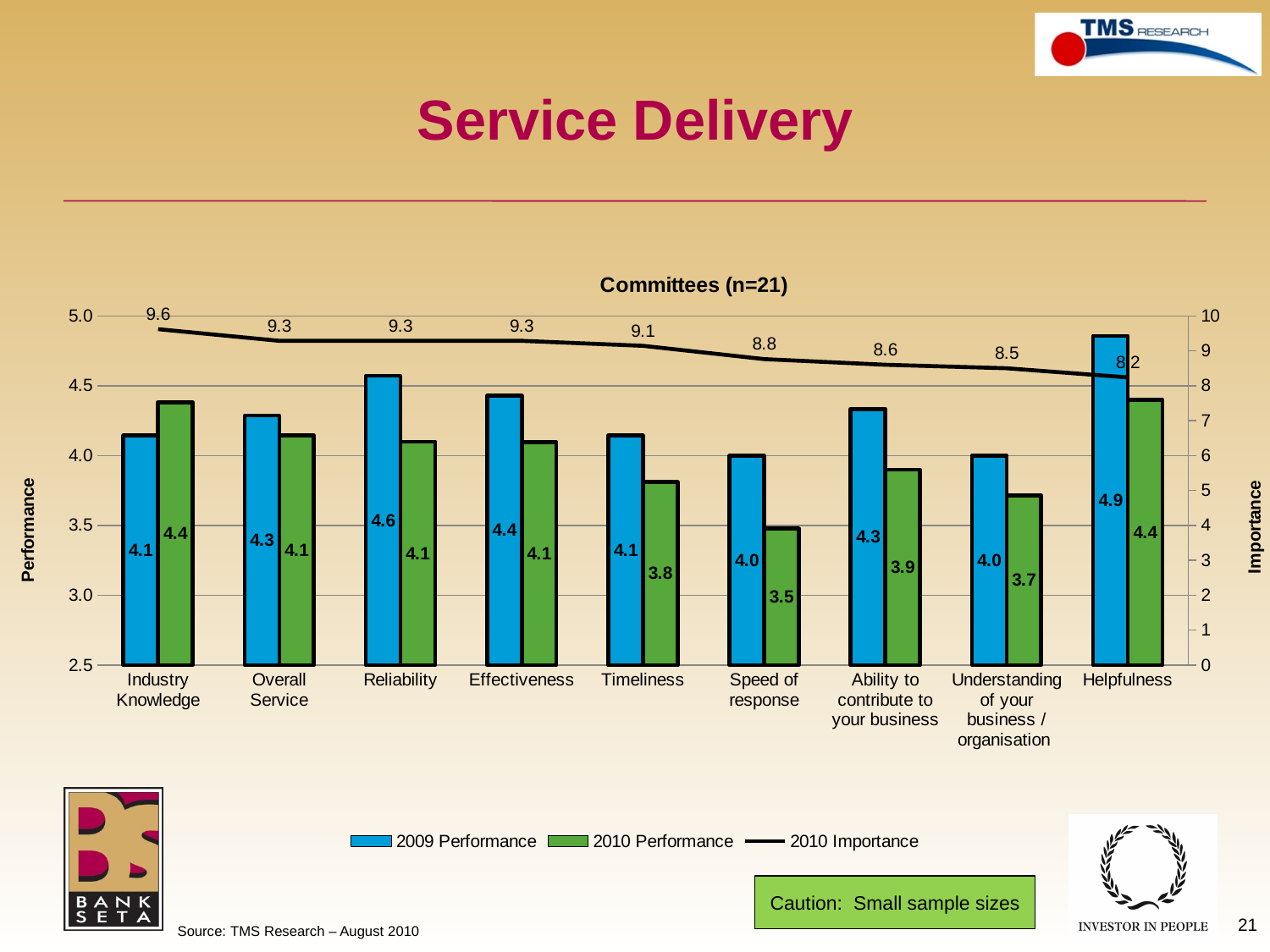
What is the 2010 Importance value for Industry Knowledge? 9.6 What is the title of the chart? Committees (n=21) How many series does the legend list? 3 What is the 2009 Performance value for Reliability? 4.6 What is the difference between the 2009 Performance and 2010 Performance values for Timeliness? 0.3 Which is larger for Industry Knowledge: the 2009 Performance value or the 2010 Performance value? 2010 Performance Which category has the lowest 2010 Performance value? Speed of response Does the 2010 Importance line rise or fall from Industry Knowledge to Helpfulness? fall How many categories are shown on the x axis? 9 What is the 2010 Performance value for Speed of response? 3.5 What kind of chart is used to show the 2009 and 2010 Performance series? bar chart Which category has the highest 2009 Performance value? Helpfulness